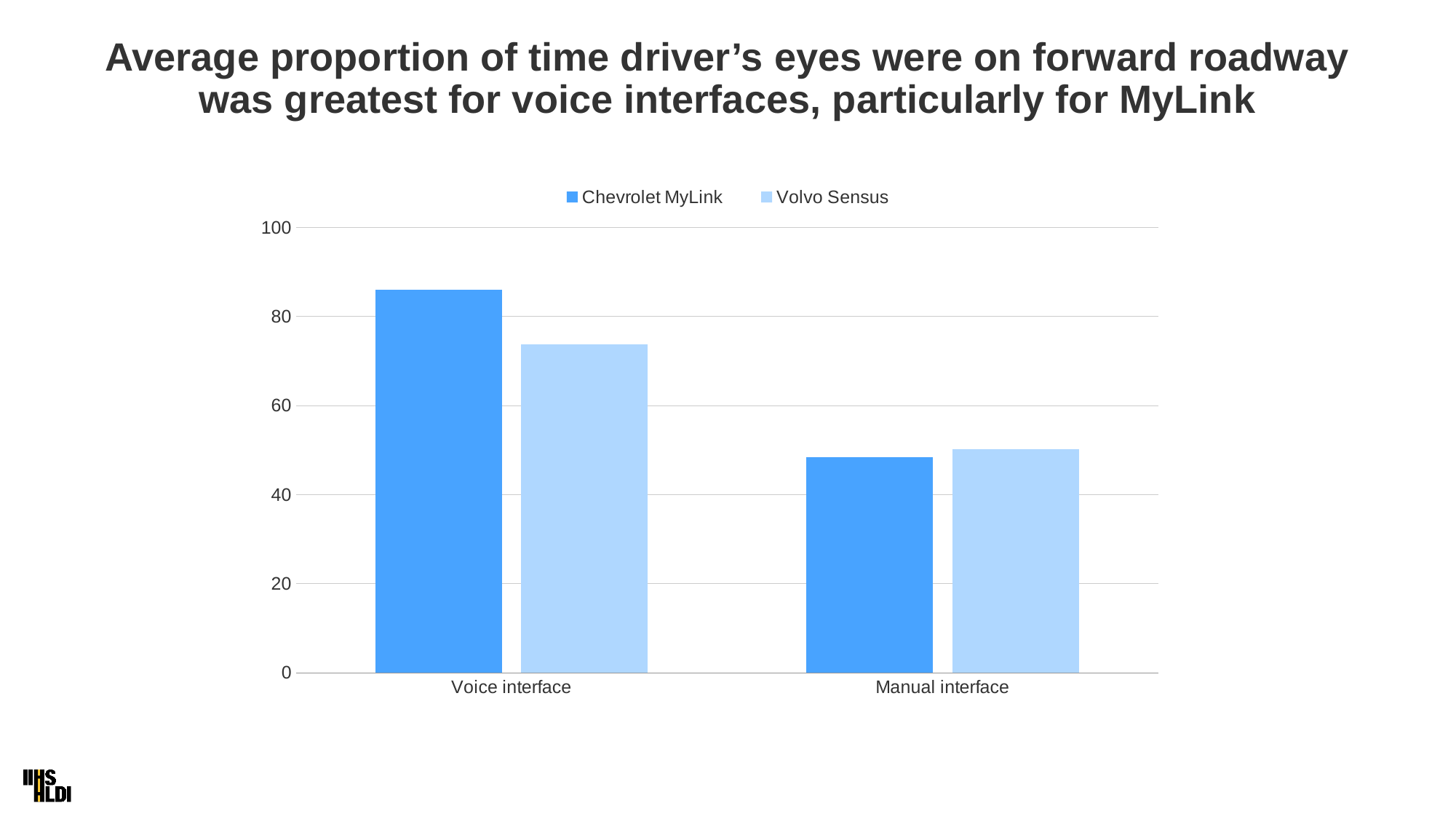
Is the value for Chevrolet MyLink with the Manual interface greater or less than 60? less Which series are listed in the legend? Chevrolet MyLink and Volvo Sensus How many categories are shown on the x axis? 2 Which bar is the highest on the chart? Chevrolet MyLink, Voice interface Is the value for Chevrolet MyLink with the Voice interface greater or less than 80? greater For Volvo Sensus, which is larger: Voice interface or Manual interface? Voice interface Is the value for Volvo Sensus with the Manual interface greater or less than 40? greater How many series does the legend list? 2 What kind of chart is shown on the slide? Bar chart For the Voice interface, which is larger: Chevrolet MyLink or Volvo Sensus? Chevrolet MyLink Do the Chevrolet MyLink values rise or fall from Voice interface to Manual interface? fall